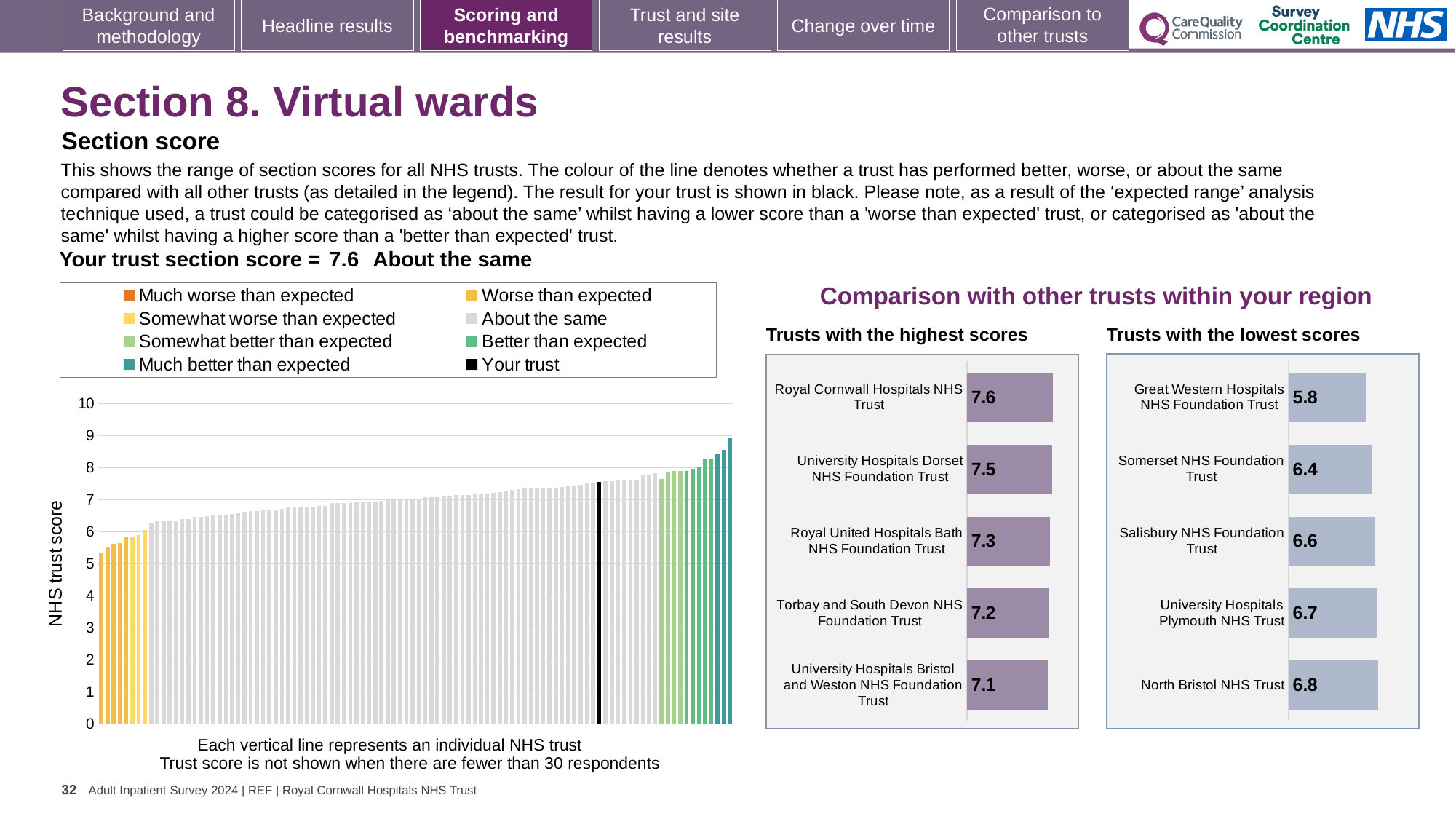
In the 'Trusts with the lowest scores' chart, which has the larger score: Salisbury NHS Foundation Trust or University Hospitals Plymouth NHS Trust? University Hospitals Plymouth NHS Trust What kind of chart is the large chart on the left showing NHS trust scores? Bar chart How many entries does the legend above the large chart on the left list? 8 In the 'Trusts with the lowest scores' chart, what is the score for Somerset NHS Foundation Trust? 6.4 In the 'Trusts with the highest scores' chart, which trust has the highest score? Royal Cornwall Hospitals NHS Trust How many trusts are shown in the 'Trusts with the highest scores' chart? 5 In the 'Trusts with the lowest scores' chart, which trust has the lowest score? Great Western Hospitals NHS Foundation Trust In the 'Trusts with the highest scores' chart, what is the score for Royal Cornwall Hospitals NHS Trust? 7.6 In the large chart on the left, do the NHS trust scores rise or fall from left to right? Rise In the 'Trusts with the highest scores' chart, what is the score for Torbay and South Devon NHS Foundation Trust? 7.2 In the 'Trusts with the highest scores' chart, what is the difference between the scores of Royal Cornwall Hospitals NHS Trust and University Hospitals Bristol and Weston NHS Foundation Trust? 0.5 In the 'Trusts with the lowest scores' chart, what is the difference between the scores of North Bristol NHS Trust and Great Western Hospitals NHS Foundation Trust? 1.0